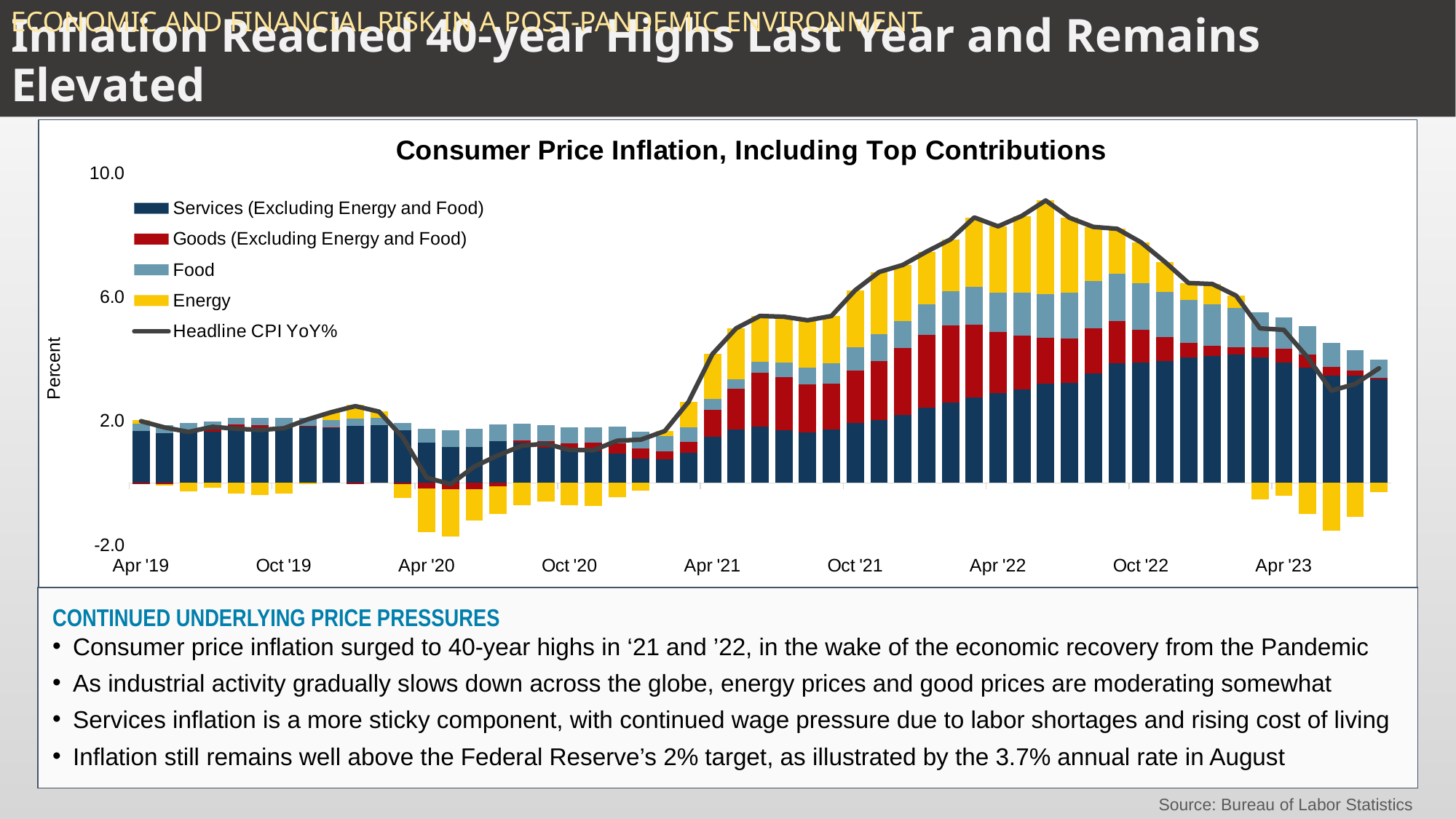
Is the peak of the Headline CPI YoY% line greater or less than 10.0? less Does the Headline CPI YoY% line rise or fall between Apr '20 and Apr '22? rise How many series does the chart's legend list? 5 Which is larger, the Headline CPI YoY% at Apr '22 or at Apr '23? Apr '22 Which series is plotted as a line rather than as bars? Headline CPI YoY% What is the title of the chart on the slide? Consumer Price Inflation, Including Top Contributions Is the Headline CPI YoY% value at Apr '22 greater or less than 6.0? greater Does the Headline CPI YoY% line rise or fall between Apr '22 and Apr '23? fall Is the Headline CPI YoY% value at Apr '21 greater or less than 2.0? greater What kind of chart is shown on the slide? Stacked bar chart with a line